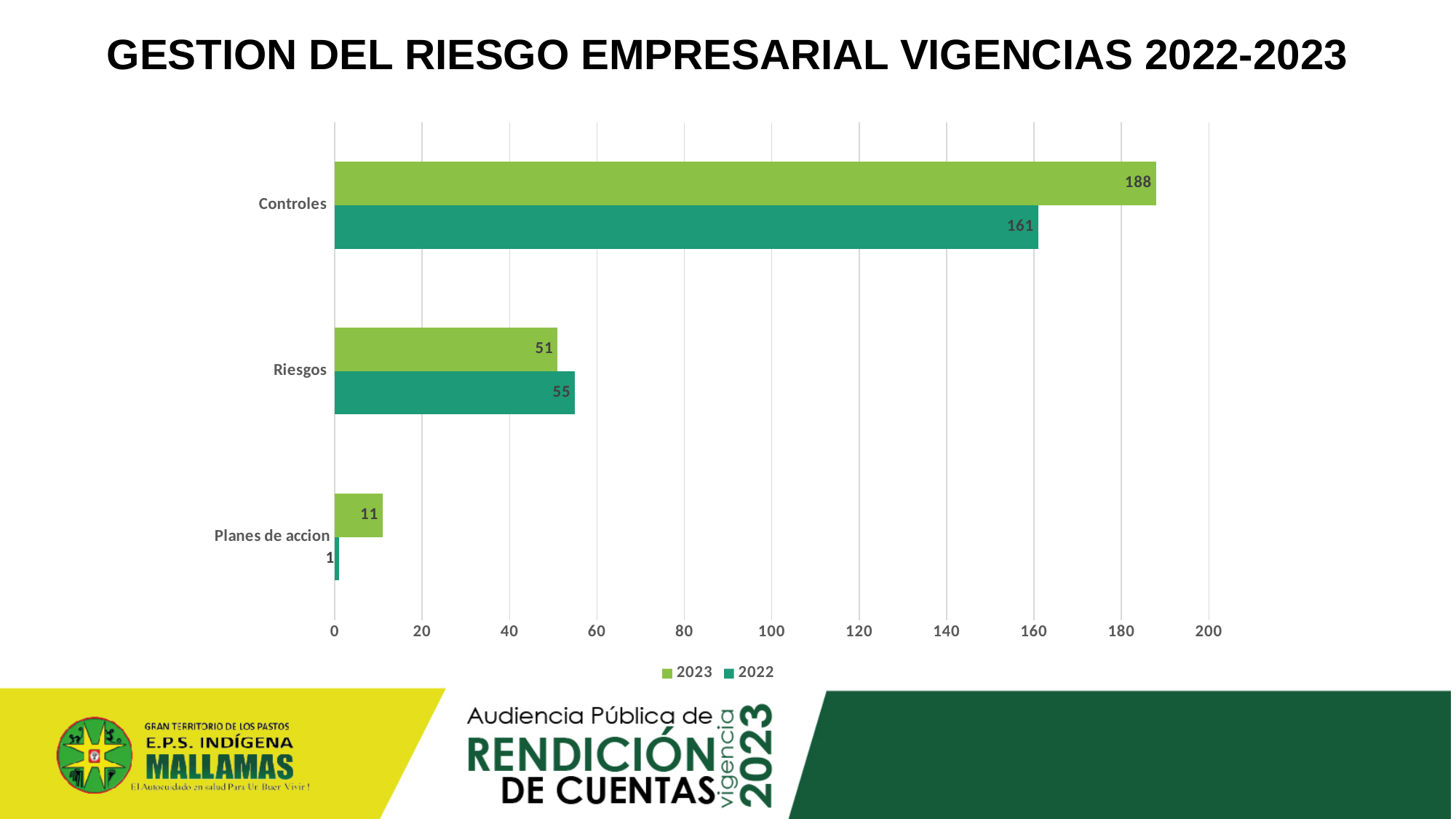
How many categories are shown on the chart? 3 Is the 2022 value for Controles greater or less than 140? greater Which is larger for Riesgos, the 2023 value or the 2022 value? 2022 What is the value for Controles in 2023? 188 What kind of chart is shown on the slide? bar chart How many series does the legend list? 2 What is the difference between the 2023 and 2022 values for Controles? 27 What is the value for Riesgos in 2022? 55 What is the title of the slide? GESTION DEL RIESGO EMPRESARIAL VIGENCIAS 2022-2023 Which category has the lowest value in the 2022 series? Planes de accion What is the value for Planes de accion in 2022? 1 Which category has the highest value in the 2023 series? Controles